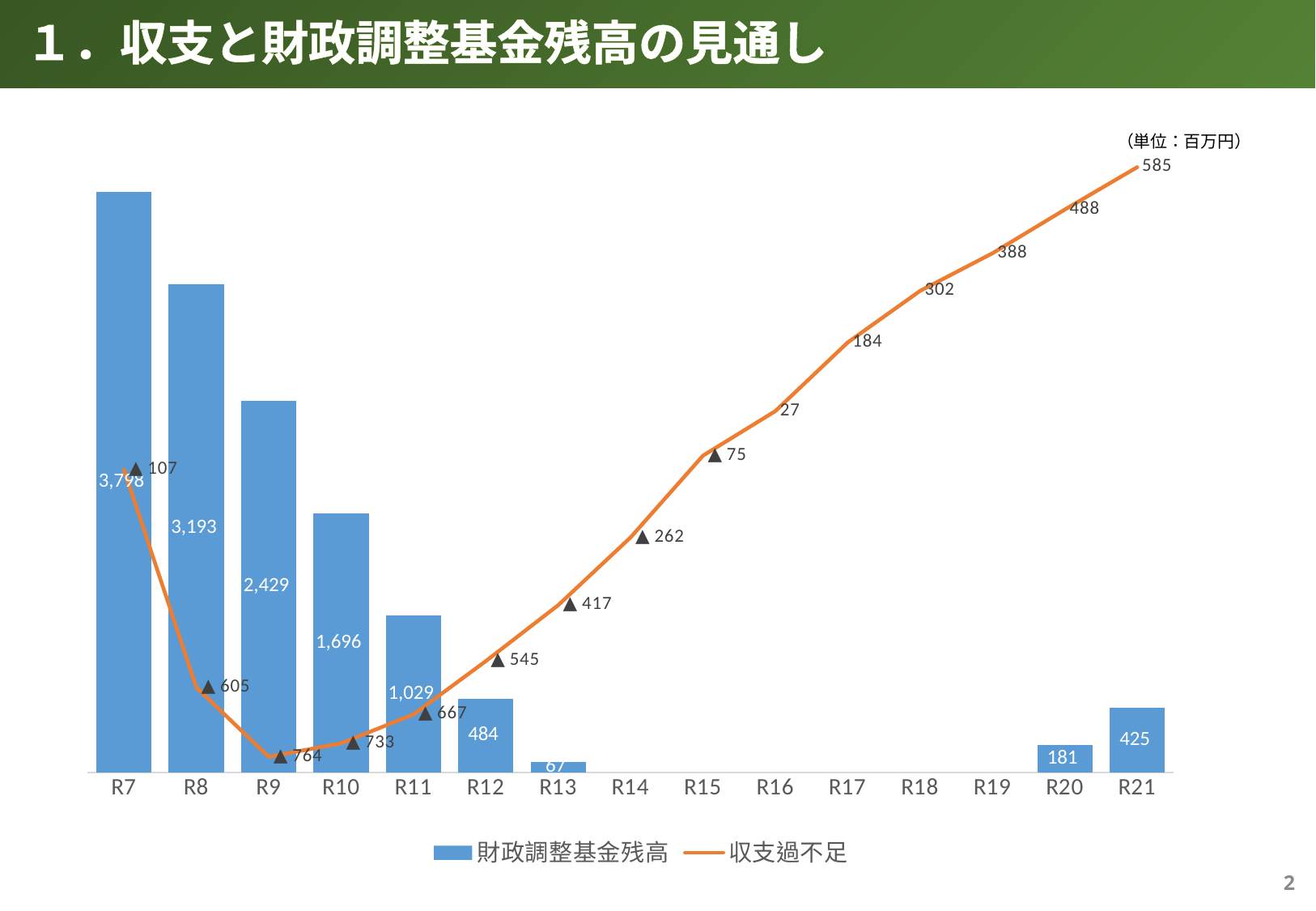
What is the value of 収支過不足 for R21? 585 Which is larger, the 財政調整基金残高 for R12 or for R21? R12 What is the difference between the 財政調整基金残高 for R7 and R8? 605 What is the value of 財政調整基金残高 for R7? 3,798 How many years are shown on the x axis? 15 Which year has the highest 収支過不足 value on the line? R21 What is the value of 収支過不足 for R9? ▲ 764 Which year has the highest 財政調整基金残高? R7 What kind of chart is this? Combined bar and line chart What is the value of 財政調整基金残高 for R20? 181 Does the 収支過不足 line rise or fall from R9 to R21? Rise How many series does the legend list? 2